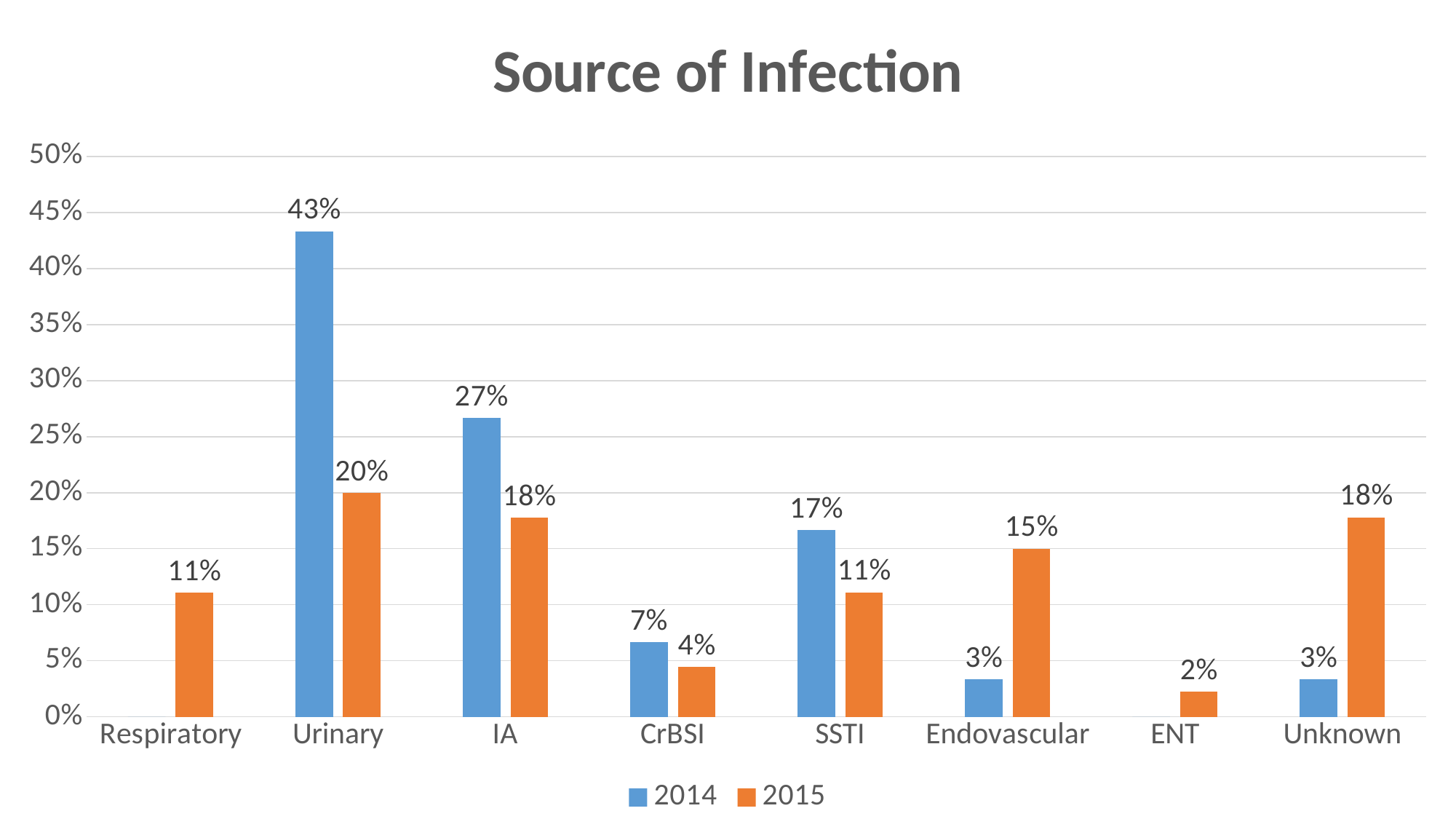
What is the 2015 value for Respiratory? 11% What is the 2015 value for Endovascular? 15% What is the difference between the 2014 and 2015 values for Urinary? 23% How many series does the legend list? 2 What is the 2014 value for Urinary? 43% Which category has the highest 2014 value? Urinary Which is larger for SSTI, the 2014 value or the 2015 value? 2014 Which category has the lowest 2015 value? ENT What is the title of the chart? Source of Infection How many categories are shown on the x axis? 8 Is the 2014 value for IA greater or less than 25%? greater What kind of chart is shown? bar chart